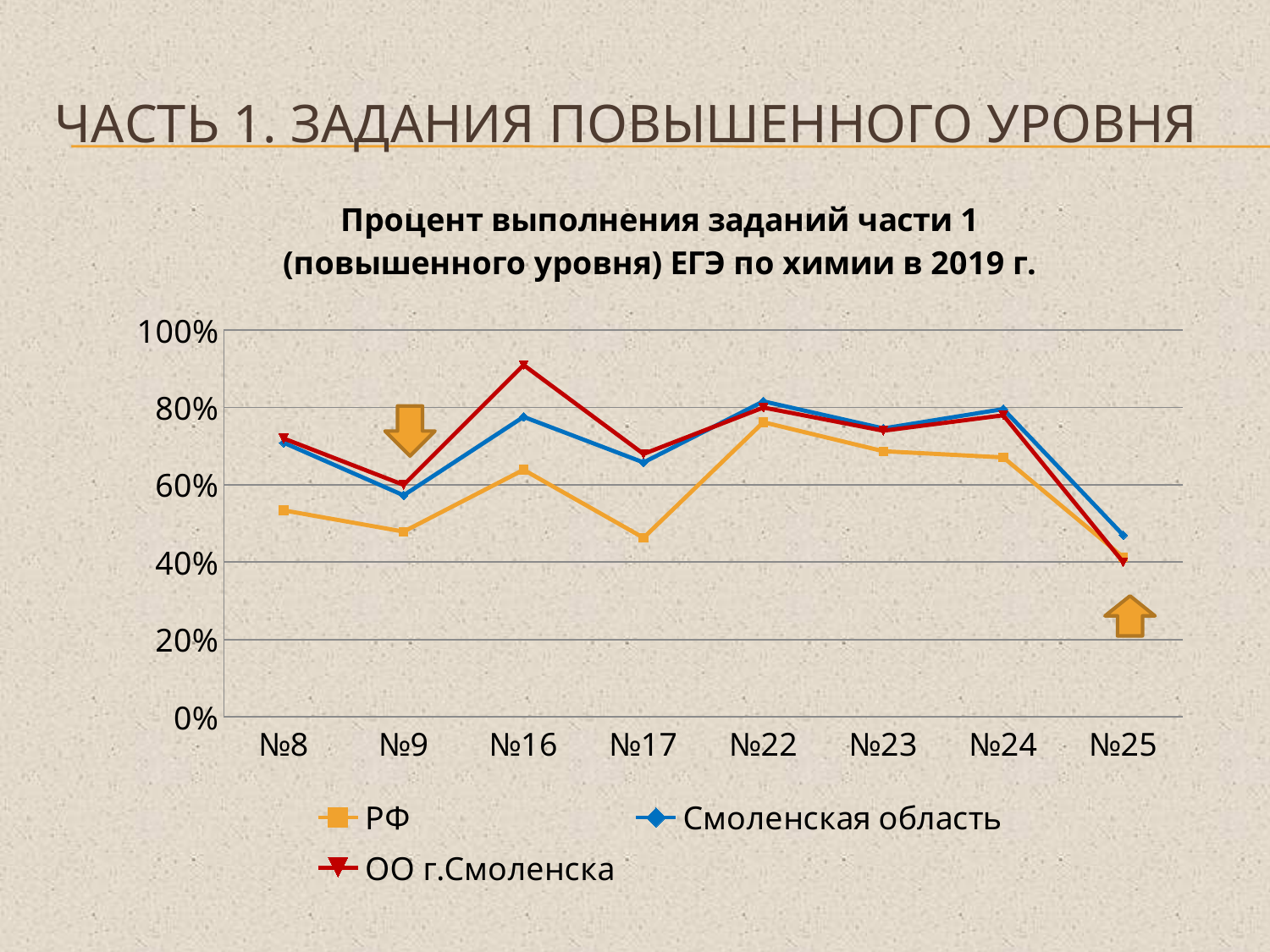
Do the values for all three series rise or fall from №24 to №25? fall For which task does the Смоленская область series have its lowest value? №25 For which task does the РФ series reach its highest value? №22 How many series does the legend list? 3 Which series is drawn in red? ОО г.Смоленска Is the value for ОО г.Смоленска at №16 greater or less than 80%? greater Is the value for РФ at №8 greater or less than 60%? less At №16, which is larger: the value for ОО г.Смоленска or the value for РФ? ОО г.Смоленска How many task categories are shown on the x axis? 8 What kind of chart is shown on the slide? line chart For which task does the ОО г.Смоленска series reach its highest value? №16 What is the title of the chart? Процент выполнения заданий части 1 (повышенного уровня) ЕГЭ по химии в 2019 г.